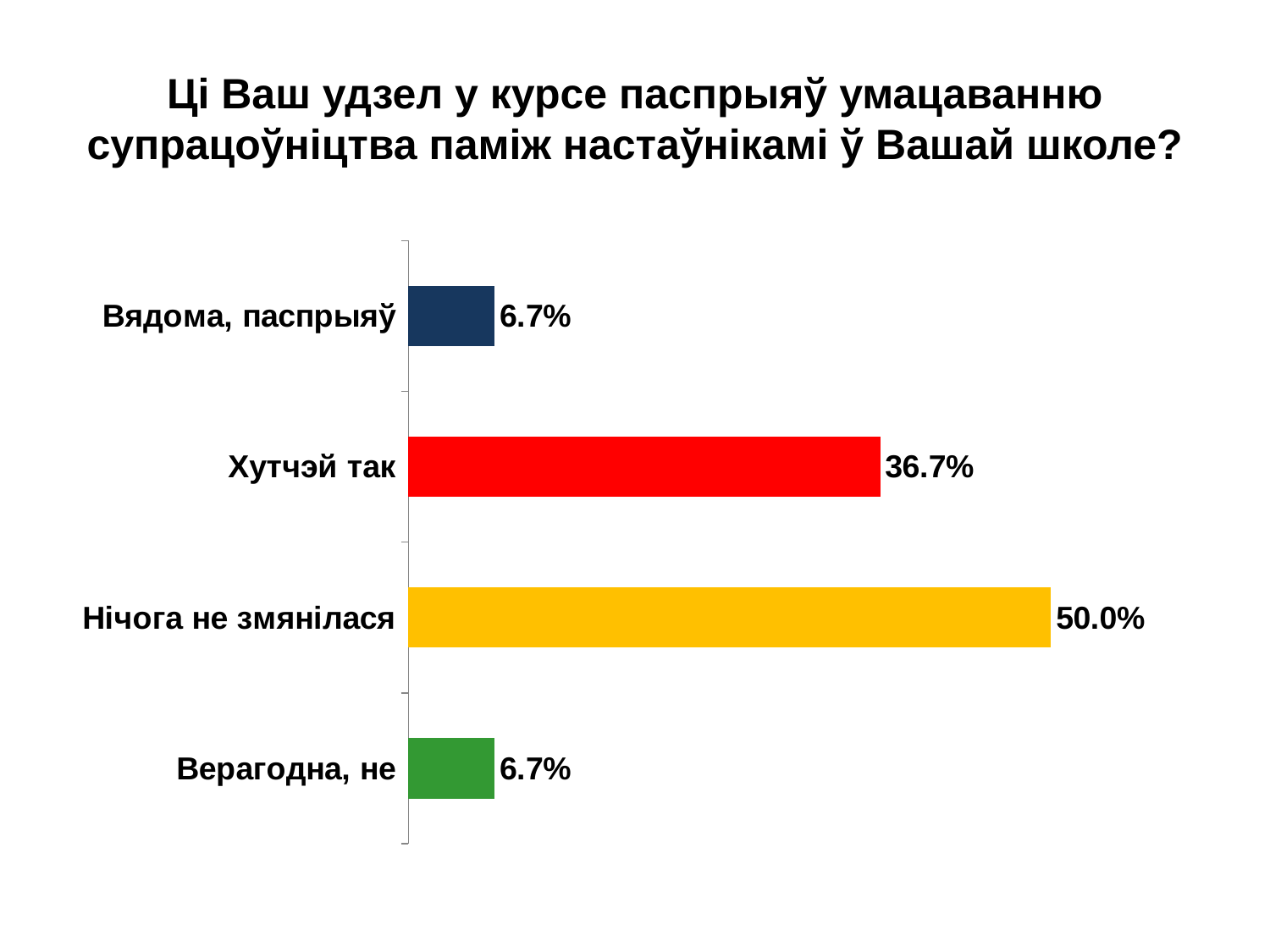
Which category has the highest value? Нічога не змянілася What colour is the bar for "Нічога не змянілася"? yellow How many categories are shown in the chart? 4 What is the difference between the values for "Хутчэй так" and "Вядома, паспрыяў"? 30.0% What colour is the bar for "Хутчэй так"? red Which is larger, the value for "Хутчэй так" or the value for "Верагодна, не"? Хутчэй так What kind of chart is shown on the slide? bar chart What is the value for "Хутчэй так"? 36.7% What is the value for "Вядома, паспрыяў"? 6.7% What is the difference between the values for "Нічога не змянілася" and "Хутчэй так"? 13.3% What is the value for "Верагодна, не"? 6.7% What is the value for "Нічога не змянілася"? 50.0%